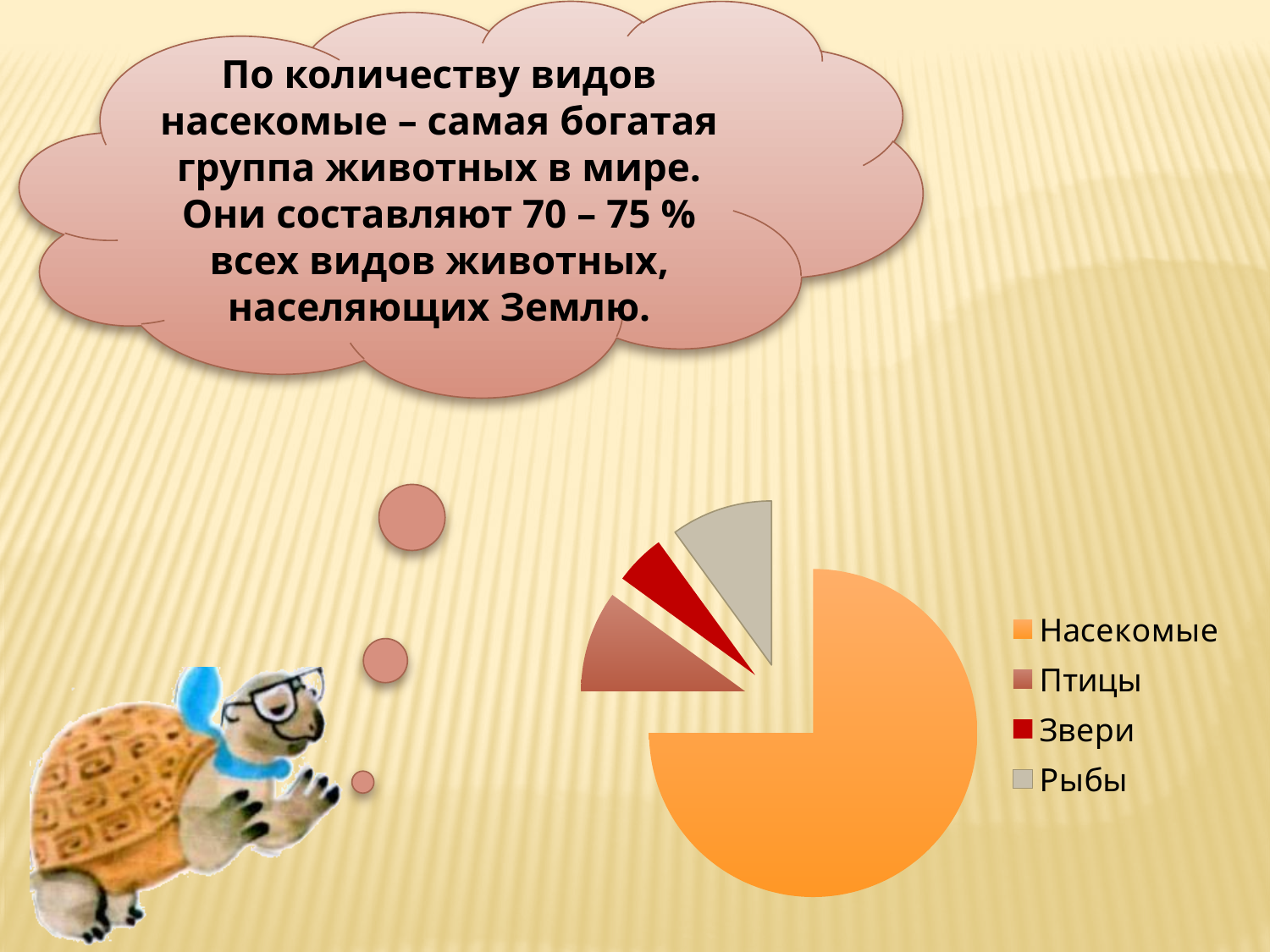
Which category has the largest slice in the pie chart? Насекомые How many slices does the pie chart have? 4 How many entries does the legend of the pie chart list? 4 What colour is the Насекомые slice in the pie chart? orange What kind of chart is shown on the slide? pie chart Which slice is larger in the pie chart, Насекомые or Птицы? Насекомые Which legend entry is shown in grey in the pie chart? Рыбы Which slice is larger in the pie chart, Птицы or Звери? Птицы Which category has the smallest slice in the pie chart? Звери